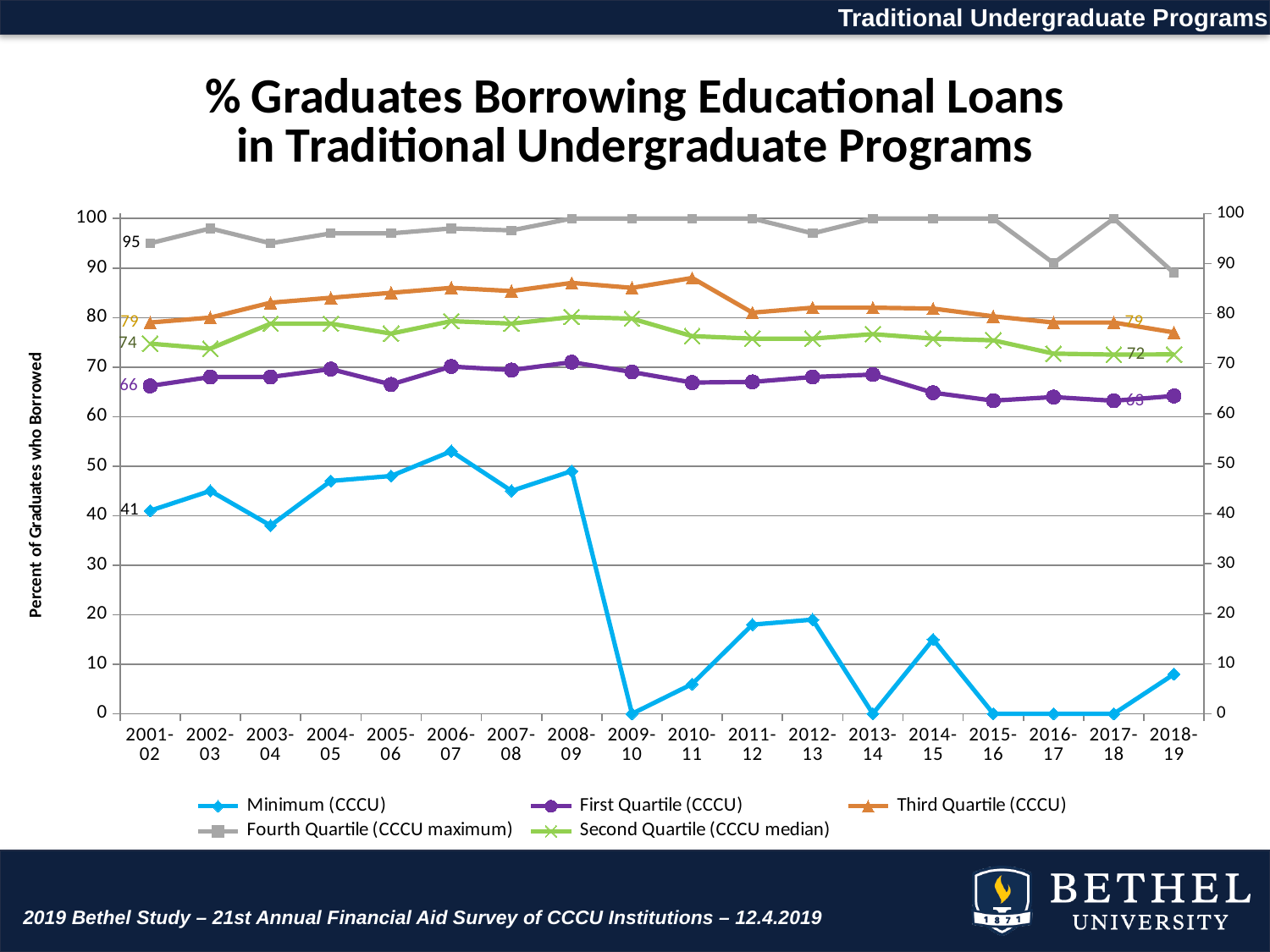
Is the value for Minimum (CCCU) in 2009-10 greater or less than 10? less Which is larger in 2001-02, the Third Quartile (CCCU) or the Second Quartile (CCCU median)? Third Quartile (CCCU) What is the value for Fourth Quartile (CCCU maximum) in 2001-02? 95 What is the value for Minimum (CCCU) in 2001-02? 41 How many academic years are shown along the x axis? 18 Does the Minimum (CCCU) series rise or fall overall from 2001-02 to 2018-19? fall What is the value for First Quartile (CCCU) in 2001-02? 66 What kind of chart is shown on the slide? line chart How many series does the legend list? 5 What is the title of the vertical axis? Percent of Graduates who Borrowed What is the value for Third Quartile (CCCU) in 2001-02? 79 What is the difference between the Fourth Quartile (CCCU maximum) and the Minimum (CCCU) values in 2001-02? 54